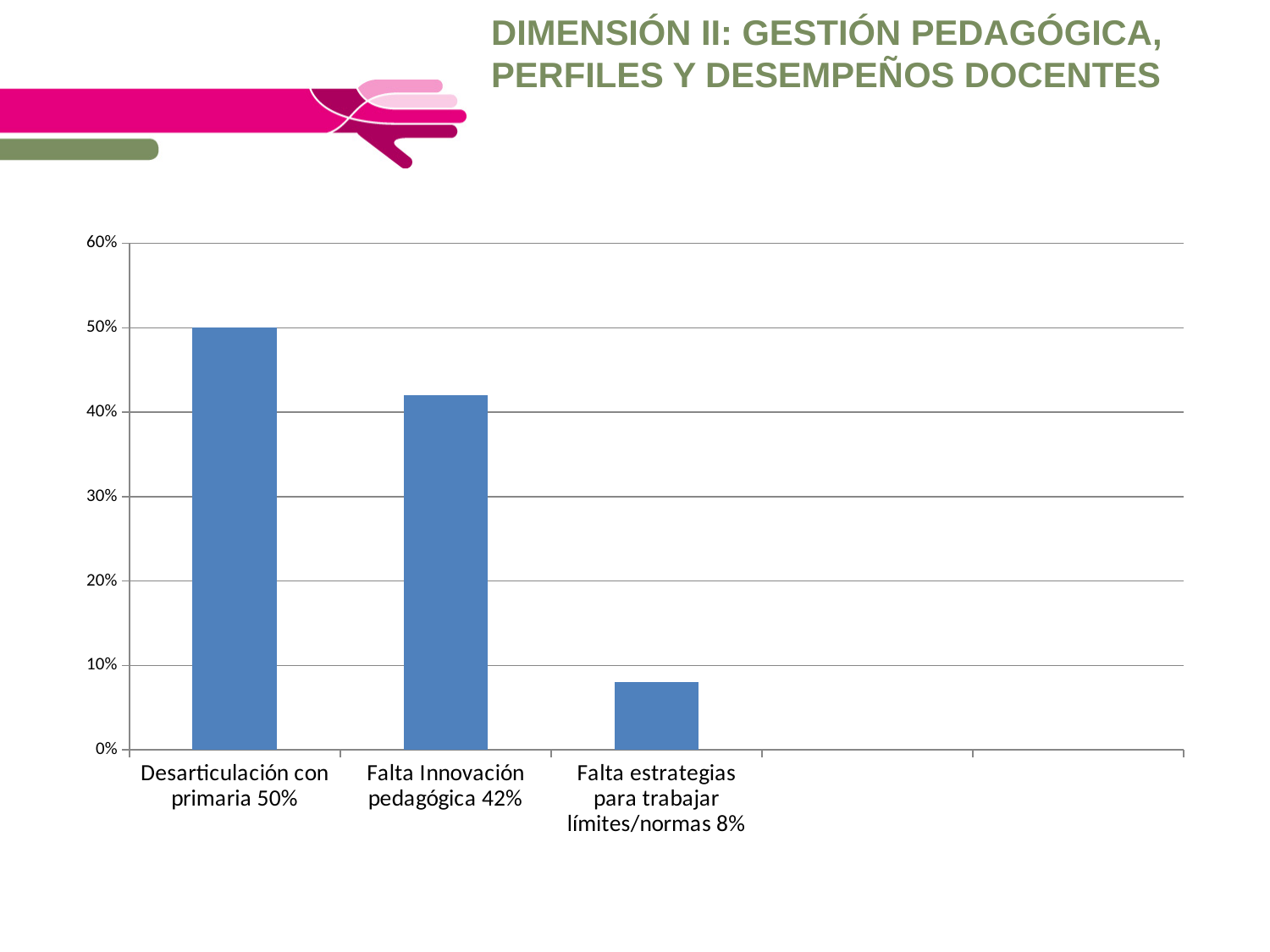
How many categories are shown in the chart? 3 What is the value for Desarticulación con primaria? 50% What is the difference between the values for Falta Innovación pedagógica and Falta estrategias para trabajar límites/normas? 34% Which category has the lowest value? Falta estrategias para trabajar límites/normas Do the values rise or fall from left to right along the x axis? fall Which category has the highest value? Desarticulación con primaria What kind of chart is shown on the slide? bar chart What is the value for Falta estrategias para trabajar límites/normas? 8% What is the value for Falta Innovación pedagógica? 42% Which is larger, the value for Falta Innovación pedagógica or the value for Falta estrategias para trabajar límites/normas? Falta Innovación pedagógica What is the difference between the values for Desarticulación con primaria and Falta Innovación pedagógica? 8% Is the value for Falta Innovación pedagógica greater or less than 40%? greater